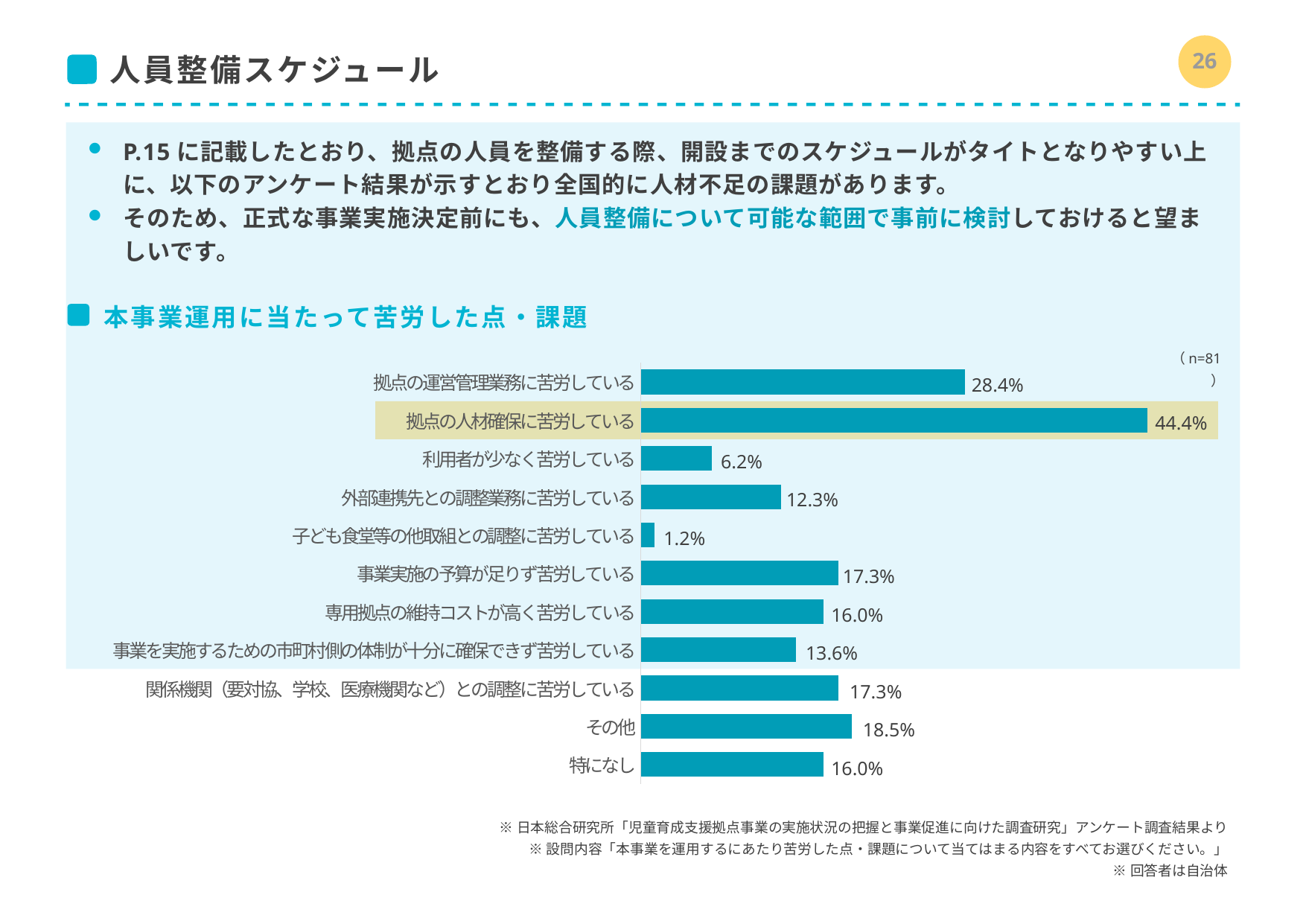
What is the value for その他? 18.5% What kind of chart is shown on the slide? Bar chart Which is larger, 利用者が少なく苦労している or 外部連携先との調整業務に苦労している? 外部連携先との調整業務に苦労している What is the value for 拠点の人材確保に苦労している? 44.4% Which category has the lowest value? 子ども食堂等の他取組との調整に苦労している What is the value for 子ども食堂等の他取組との調整に苦労している? 1.2% What is the sample size (n) shown on the chart? n=81 How many categories are shown in the chart? 11 What is the difference between 拠点の人材確保に苦労している and 拠点の運営管理業務に苦労している? 16.0% What is the value for 特になし? 16.0% Which category has the highest value? 拠点の人材確保に苦労している What is the value for 拠点の運営管理業務に苦労している? 28.4%